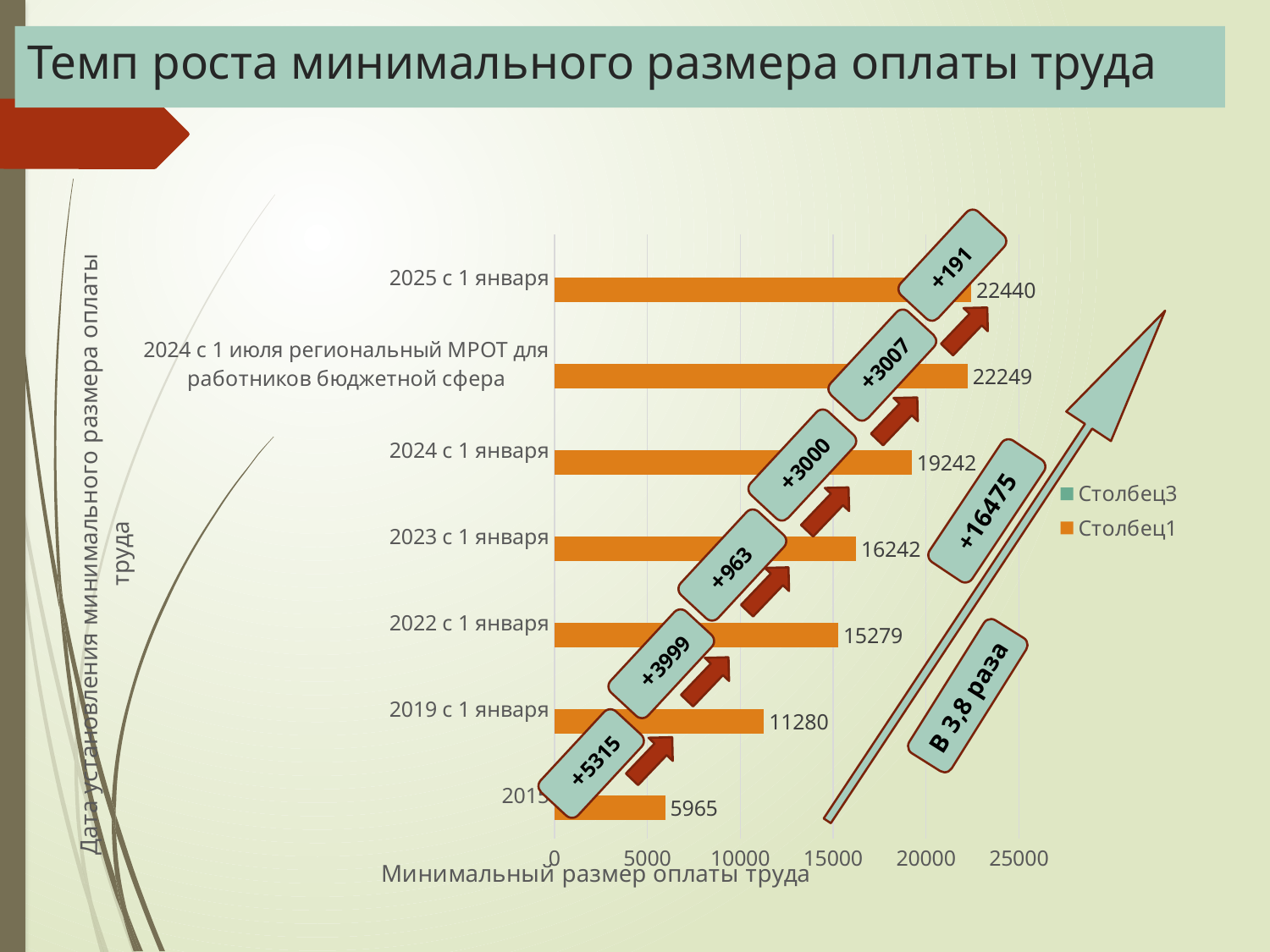
What is the value for "2019 с 1 января"? 11280 What is the value for "2025 с 1 января"? 22440 Which category has the highest value? 2025 с 1 января What is the lowest value shown on the chart? 5965 What is the value for "2024 с 1 июля региональный МРОТ для работников бюджетной сфера"? 22249 How many series does the legend list? 2 What is the difference between the values for "2024 с 1 января" and "2023 с 1 января"? 3000 What is the difference between the values for "2023 с 1 января" and "2022 с 1 января"? 963 What is the value for "2023 с 1 января"? 16242 Which is larger, the value for "2022 с 1 января" or for "2019 с 1 января"? 2022 с 1 января How many bars are plotted on the chart? 7 What kind of chart is shown on the slide? Bar chart